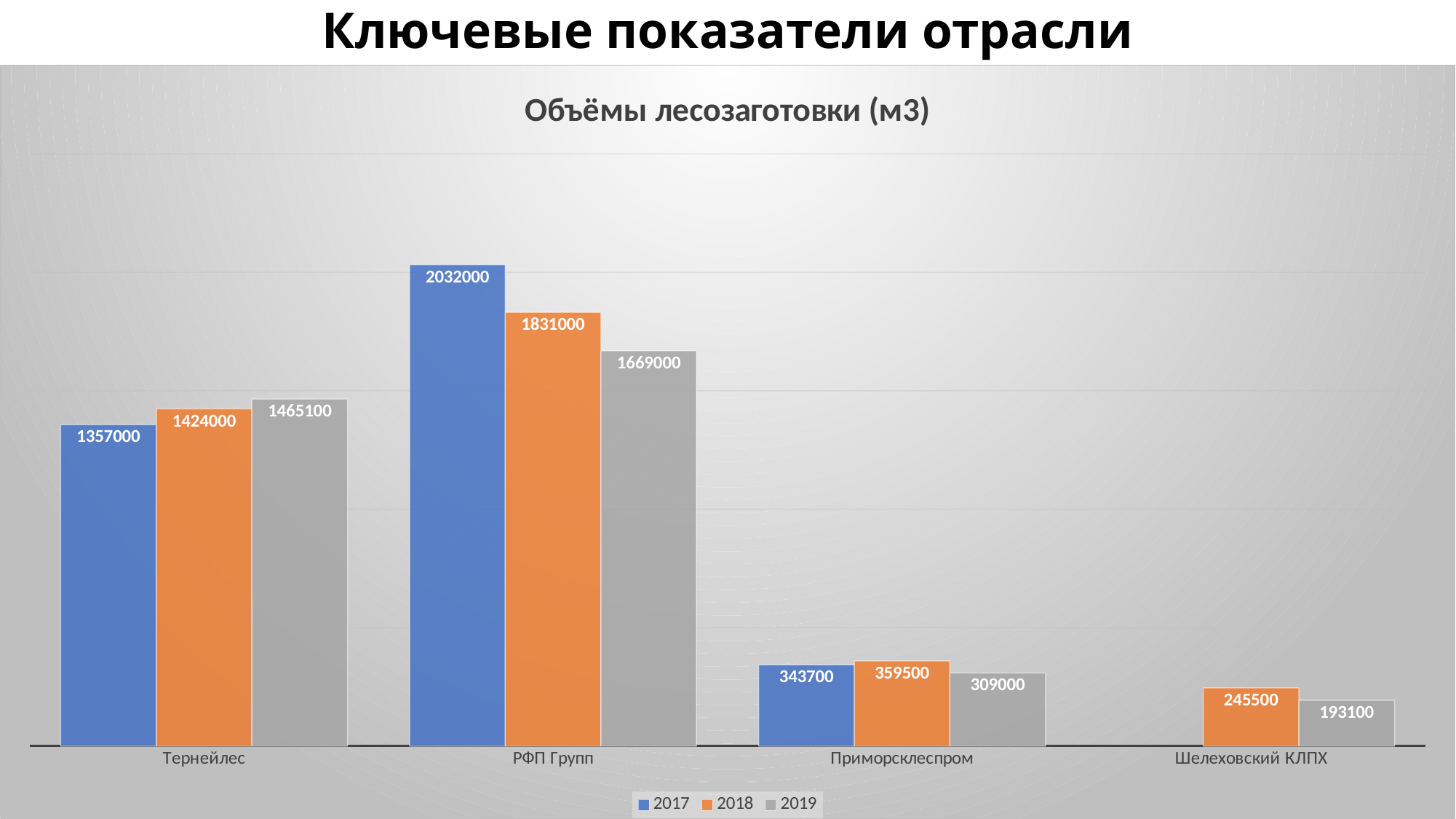
What is the 2019 value for Тернейлес? 1465100 How many categories are shown on the x axis? 4 What is the difference between the 2018 and 2019 values for Шелеховский КЛПХ? 52400 Which category has the highest 2017 value? РФП Групп Which category has the lowest 2019 value? Шелеховский КЛПХ Do the values for РФП Групп rise or fall from 2017 to 2019? fall How many series does the legend list? 3 What is the difference between the 2017 and 2019 values for РФП Групп? 363000 What is the 2017 value for Приморсклеспром? 343700 Which is larger for Тернейлес: the 2017 value or the 2018 value? 2018 What kind of chart is shown? bar chart What is the 2018 value for РФП Групп? 1831000